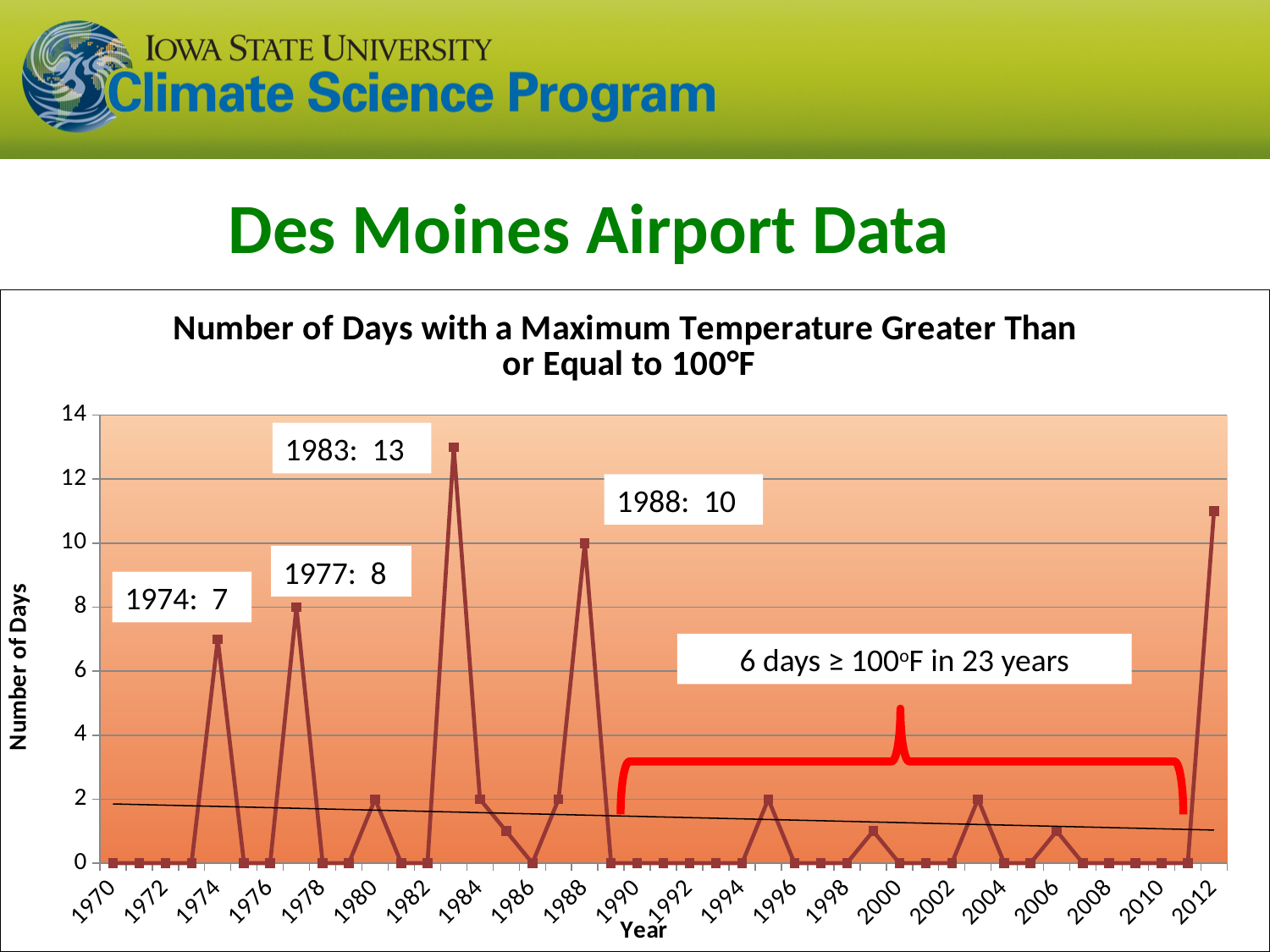
What is the difference between the labelled values for 1983 and 1988? 3 How many days at or above 100°F are labelled for 1974? 7 Which year has the highest number of days with a maximum temperature of 100°F or more? 1983 What is the number of days with a maximum temperature of 100°F or more in 1983? 13 Which year has the larger labelled value, 1974 or 1977? 1977 Is the value for 2012 greater or less than 10? greater What kind of chart is shown on the slide? line chart Does the black trend line drawn across the chart rise or fall from 1970 to 2012? falls What is the label on the vertical axis of the chart? Number of Days What is the title of the chart? Number of Days with a Maximum Temperature Greater Than or Equal to 100°F What value is labelled for 1988 on the chart? 10 What value is labelled for 1977? 8